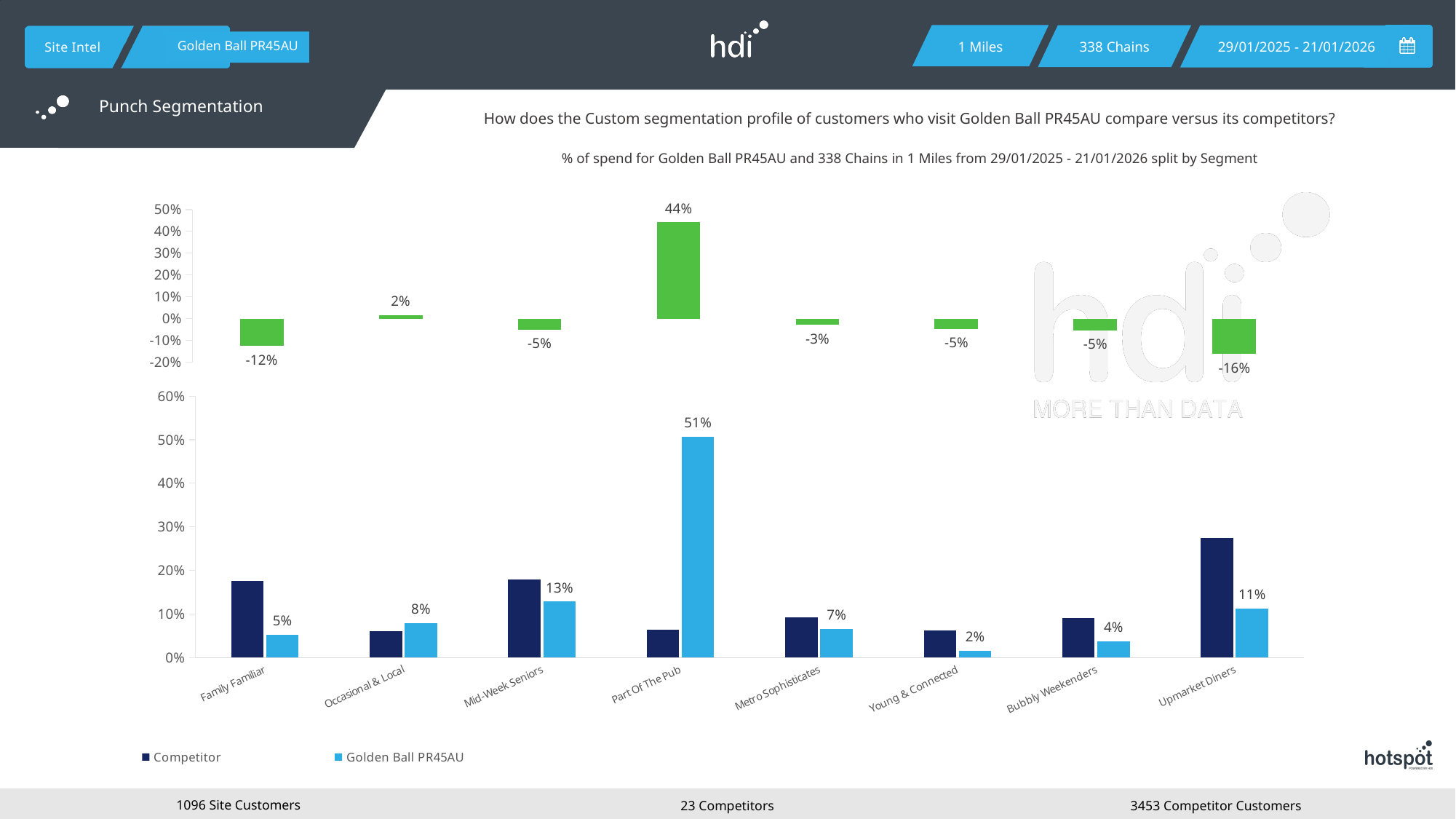
How many segments are shown on the x axis of the bottom chart? 8 In the bottom chart, which is larger for Family Familiar: the Competitor bar or the Golden Ball PR45AU bar? Competitor In the top chart, which segment has the lowest value? Upmarket Diners In the top chart, which segment has the highest value? Part Of The Pub In the bottom chart, what is the difference between the Golden Ball PR45AU values for Mid-Week Seniors and Upmarket Diners? 2% In the top chart, what is the value shown for Family Familiar? -12% In the bottom chart, is the Competitor value for Upmarket Diners greater or less than 20%? greater In the bottom chart, what is the value for Golden Ball PR45AU in the Part Of The Pub segment? 51% How many series does the legend of the bottom chart list? 2 In the bottom chart, which segment has the lowest Golden Ball PR45AU value? Young & Connected In the bottom chart, what is the value for Golden Ball PR45AU in the Young & Connected segment? 2% In the top chart, what is the value shown for Upmarket Diners? -16%